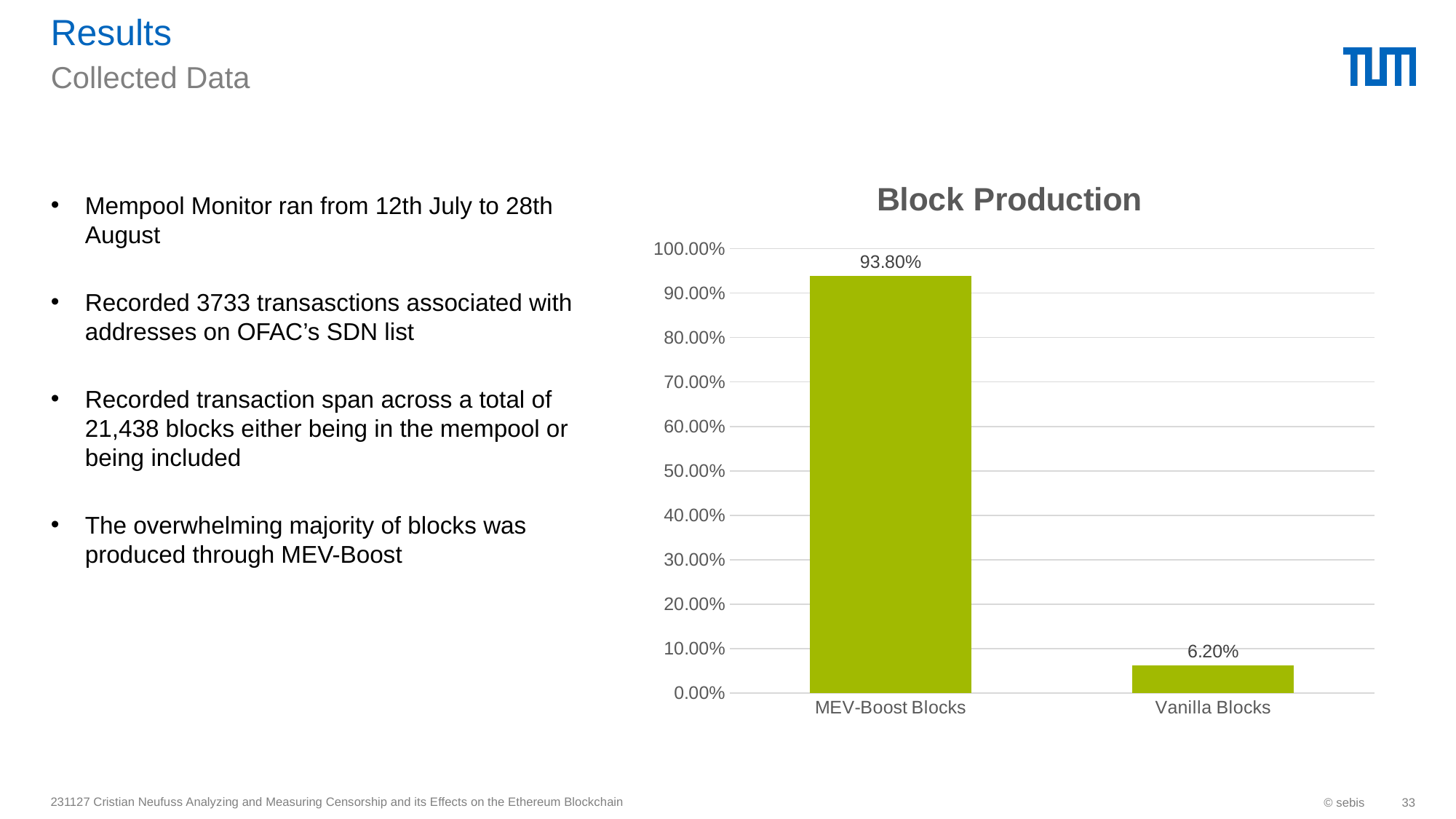
Which is larger, the value for MEV-Boost Blocks or the value for Vanilla Blocks? MEV-Boost Blocks Which category has the highest value in the Block Production chart? MEV-Boost Blocks Is the value for MEV-Boost Blocks greater or less than 90.00%? greater Which category has the lowest value in the Block Production chart? Vanilla Blocks How many categories are shown in the Block Production chart? 2 What is the title of the chart on the slide? Block Production What kind of chart is the Block Production chart? bar chart What is the difference between the values for MEV-Boost Blocks and Vanilla Blocks? 87.60% What is the value for MEV-Boost Blocks in the Block Production chart? 93.80% What is the highest value shown on the y axis of the Block Production chart? 100.00% What is the value for Vanilla Blocks in the Block Production chart? 6.20% Is the value for Vanilla Blocks greater or less than 10.00%? less